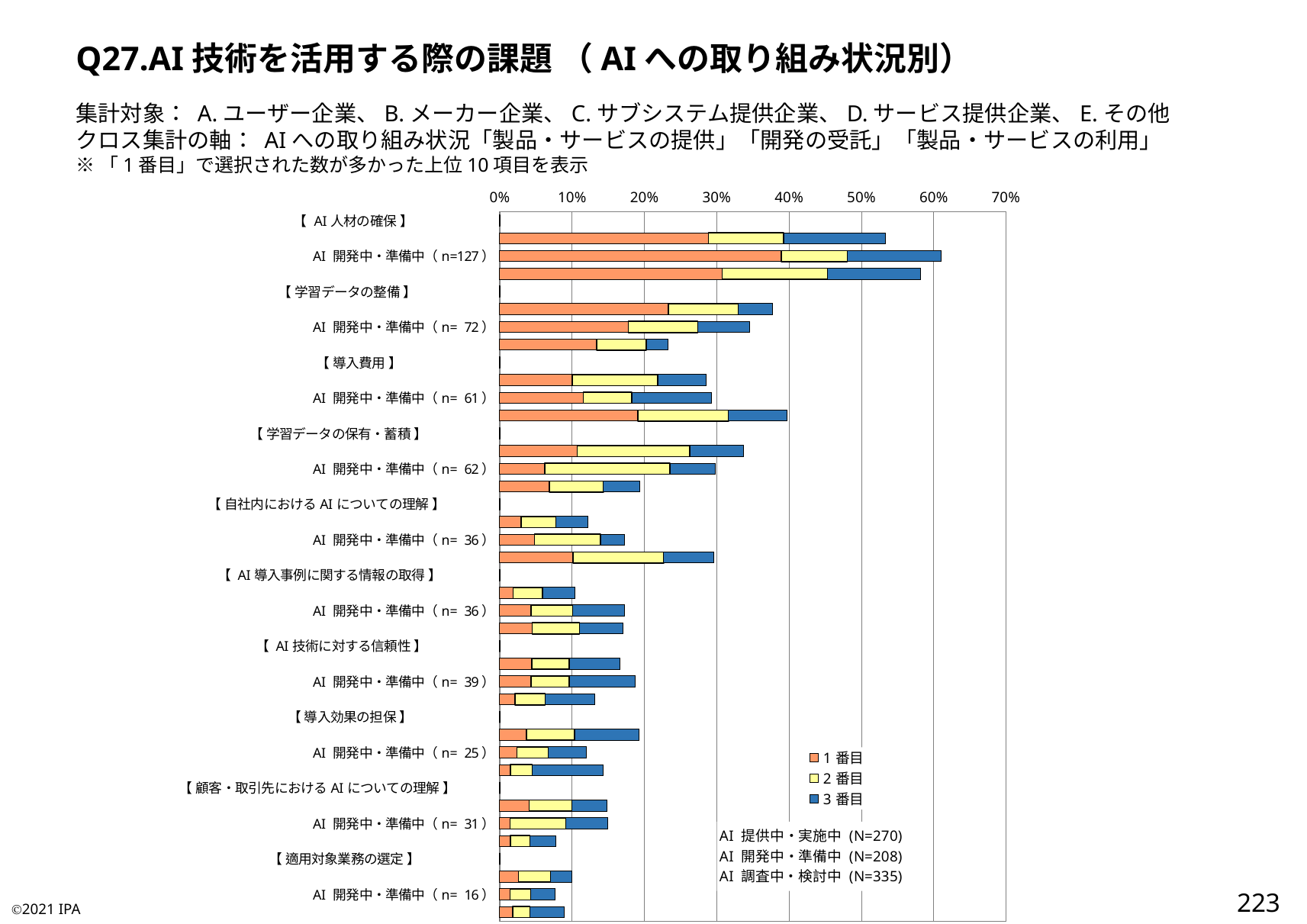
How many series does the chart legend list? 3 Which has the larger total stacked bar: AI 開発中・準備中 (n=72) under 学習データの整備 or AI 開発中・準備中 (n=61) under 導入費用? AI 開発中・準備中 (n=72) under 学習データの整備 What kind of chart is shown on the slide? Stacked horizontal bar chart What is the sample size (n) shown for AI 開発中・準備中 under 学習データの保有・蓄積? 62 Is the total stacked value for AI 開発中・準備中 (n=72) under 学習データの整備 greater or less than 40%? less Is the total stacked value for AI 開発中・準備中 (n=16) under 適用対象業務の選定 greater or less than 10%? less What is the highest value shown on the chart's percentage axis? 70% Which issue category has the longest stacked bars on the chart? AI人材の確保 Is the total stacked value for AI 開発中・準備中 (n=127) under AI人材の確保 greater or less than 50%? greater What are the three series named in the chart legend? 1番目, 2番目, 3番目 How many issue categories (bracketed headings) are shown on the chart? 10